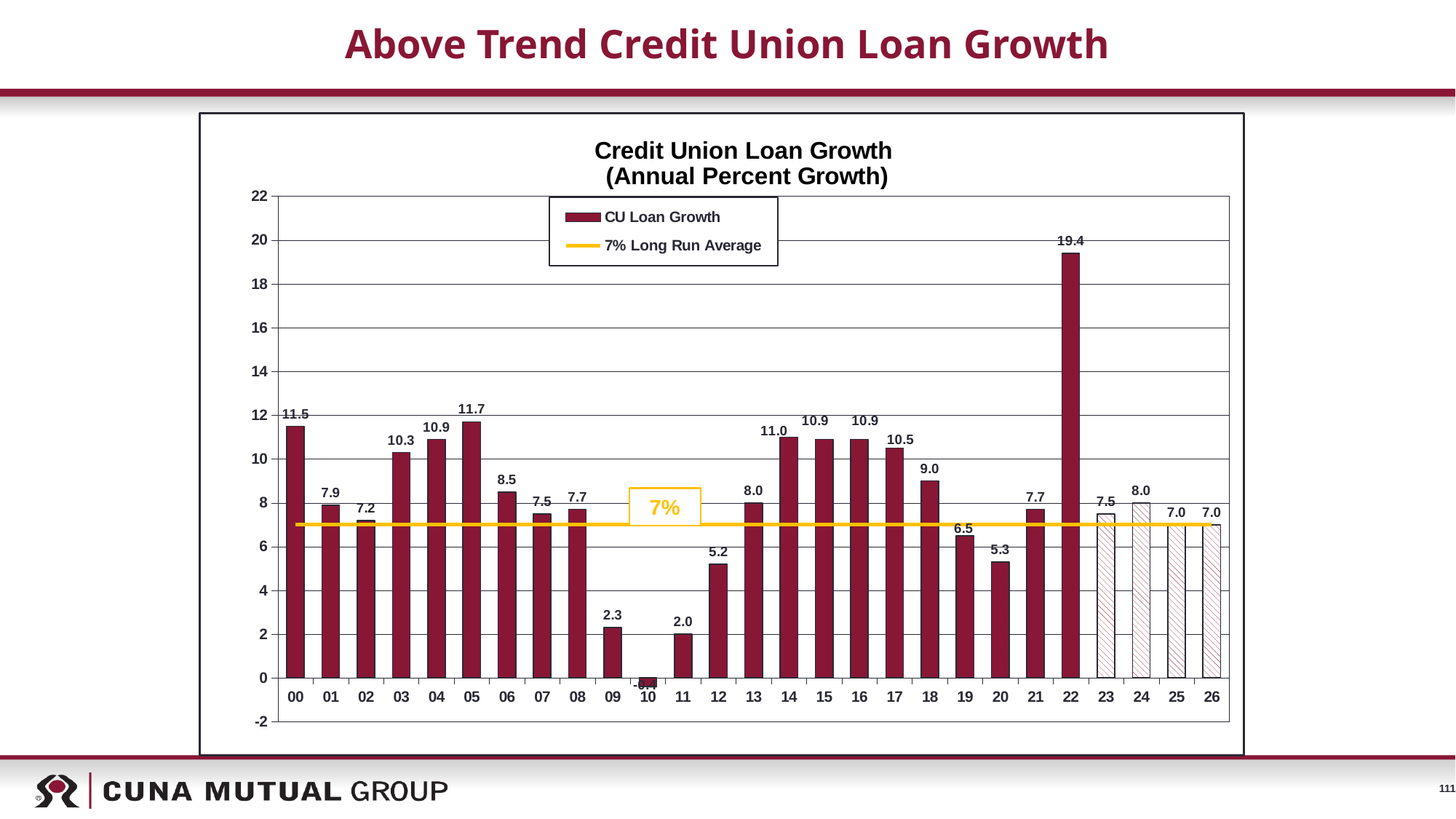
Which year has the lowest CU Loan Growth? 10 What is the difference between the CU Loan Growth values for 22 and 00? 7.9 What is the CU Loan Growth value for 22? 19.4 Is the CU Loan Growth value for 09 greater or less than 4? less What is the CU Loan Growth value for 12? 5.2 Which is larger, the CU Loan Growth value for 18 or for 19? 18 Which year has the highest CU Loan Growth? 22 What type of chart is shown? bar chart How many entries does the legend list? 2 What is the CU Loan Growth value for 05? 11.7 What is the difference between the CU Loan Growth values for 05 and 09? 9.4 How many years are shown on the x axis? 27